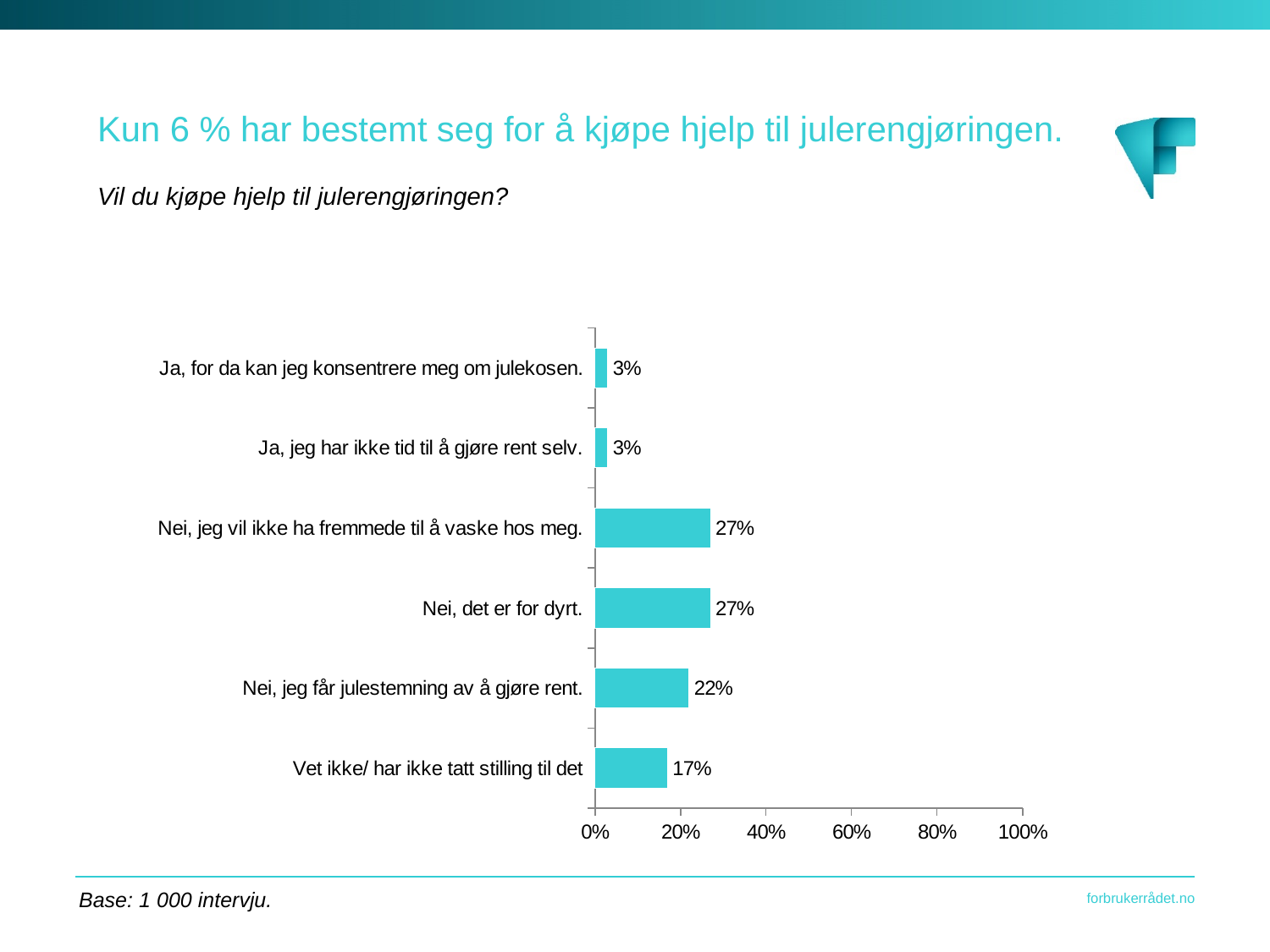
Is the value for "Nei, det er for dyrt." greater or less than 20%? greater What percentage of respondents answered "Nei, det er for dyrt."? 27% What percentage answered "Nei, jeg vil ikke ha fremmede til å vaske hos meg."? 27% What percentage chose "Nei, jeg får julestemning av å gjøre rent."? 22% What is the difference between the values for "Nei, jeg får julestemning av å gjøre rent." and "Vet ikke/ har ikke tatt stilling til det"? 5% Which is larger: the value for "Nei, jeg får julestemning av å gjøre rent." or for "Vet ikke/ har ikke tatt stilling til det"? Nei, jeg får julestemning av å gjøre rent. What kind of chart is shown on the slide? Bar chart What question is the chart based on, as shown in the subtitle? Vil du kjøpe hjelp til julerengjøringen? What is the difference between "Nei, det er for dyrt." and "Ja, for da kan jeg konsentrere meg om julekosen."? 24% What is the value for "Ja, jeg har ikke tid til å gjøre rent selv."? 3% How many answer categories are shown in the chart? 6 What is the value for "Vet ikke/ har ikke tatt stilling til det"? 17%